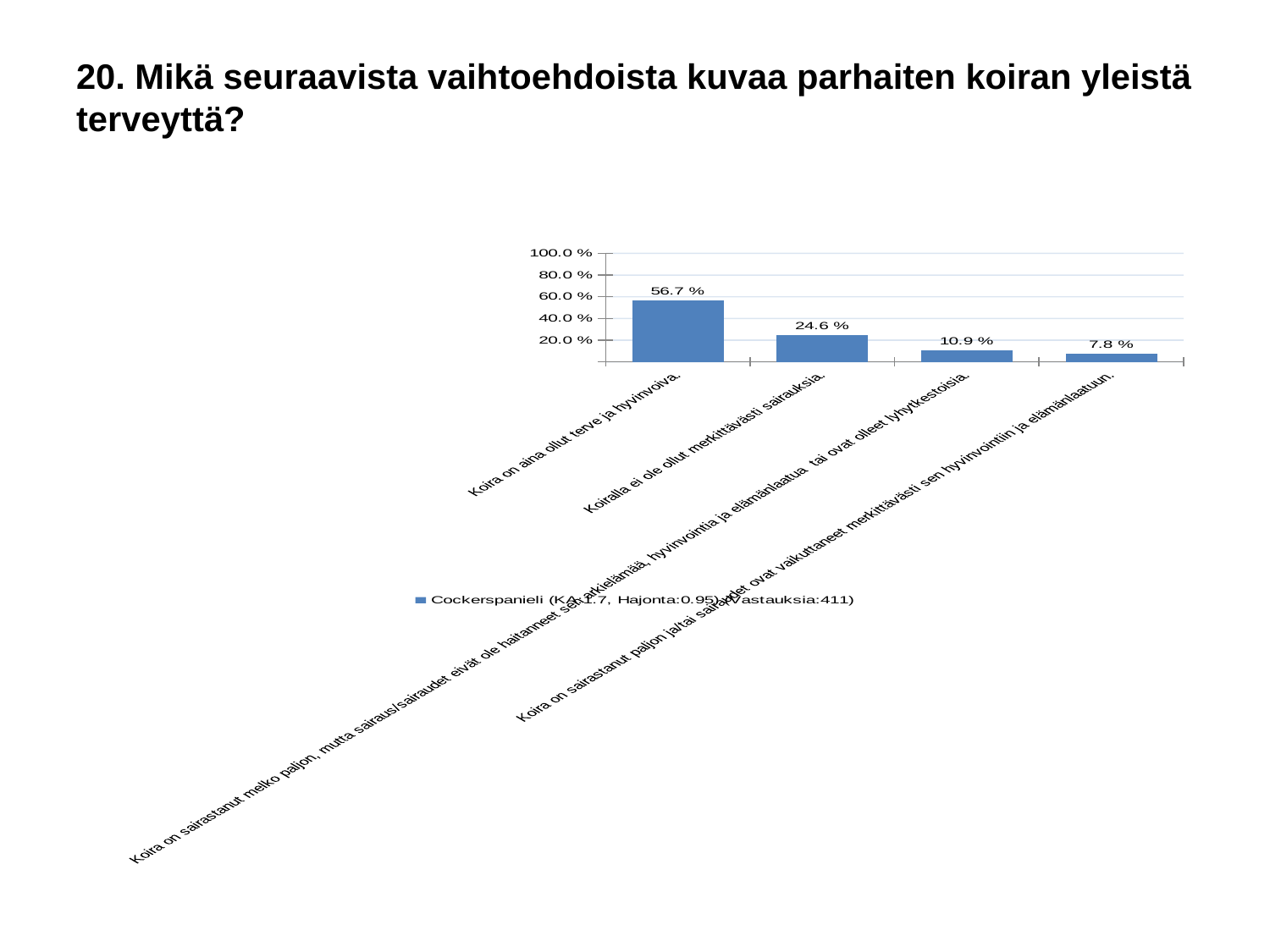
What series name does the legend show? Cockerspanieli (KA:1.7, Hajonta:0.95) (Vastauksia:411) How many categories (bars) does the chart show? 4 Which category has the lowest value? Koira on sairastanut paljon ja/tai sairaudet ovat vaikuttaneet merkittävästi sen hyvinvointiin ja elämänlaatuun. What is the value for the category beginning "Koira on sairastanut melko paljon, mutta sairaus/sairaudet eivät ole haitanneet..."? 10.9 % What type of chart is shown on the slide? bar chart What is the difference between the values for "Koira on aina ollut terve ja hyvinvoiva." and "Koiralla ei ole ollut merkittävästi sairauksia."? 32.1 % How many series does the legend list? 1 What is the value for the category beginning "Koira on sairastanut paljon ja/tai sairaudet ovat vaikuttaneet merkittävästi..."? 7.8 % Which category has the highest value? Koira on aina ollut terve ja hyvinvoiva. What is the value for the category "Koira on aina ollut terve ja hyvinvoiva."? 56.7 % Do the values rise or fall from left to right along the x axis? fall What is the value for the category "Koiralla ei ole ollut merkittävästi sairauksia."? 24.6 %